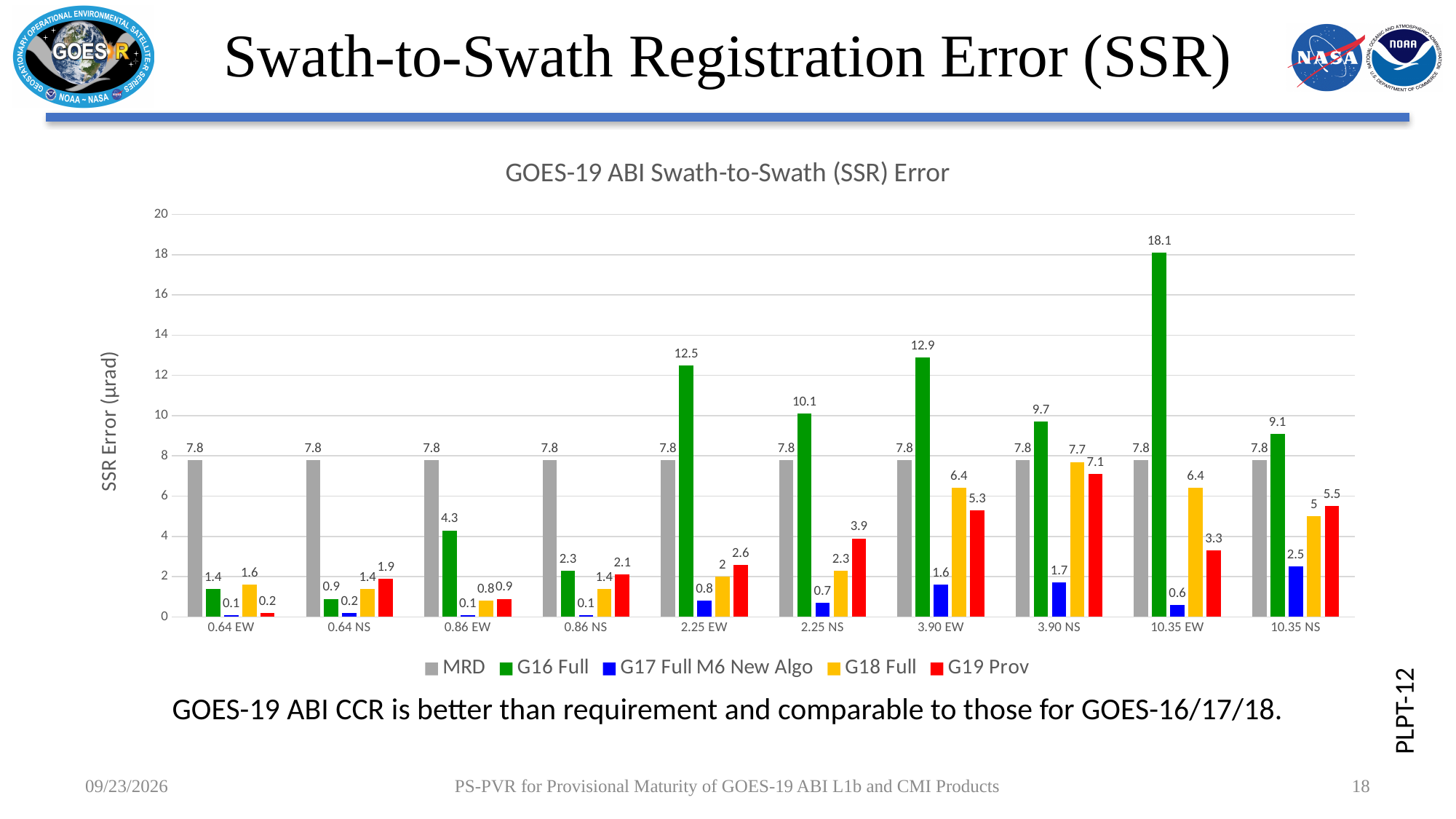
What is the difference between the G16 Full value and the MRD value for 3.90 EW? 5.1 Is the G16 Full value for 2.25 EW greater or less than 10? greater How many categories are shown on the x axis? 10 What is the G16 Full value for 10.35 EW? 18.1 Which is larger for 10.35 NS: the G18 Full value or the G19 Prov value? G19 Prov What is the G18 Full value for 2.25 NS? 2.3 How many series does the legend list? 5 What is the MRD value for 0.64 EW? 7.8 Which category has the highest G16 Full value? 10.35 EW What kind of chart is shown on the slide? bar chart Which category has the lowest G19 Prov value? 0.64 EW What is the G19 Prov value for 3.90 NS? 7.1